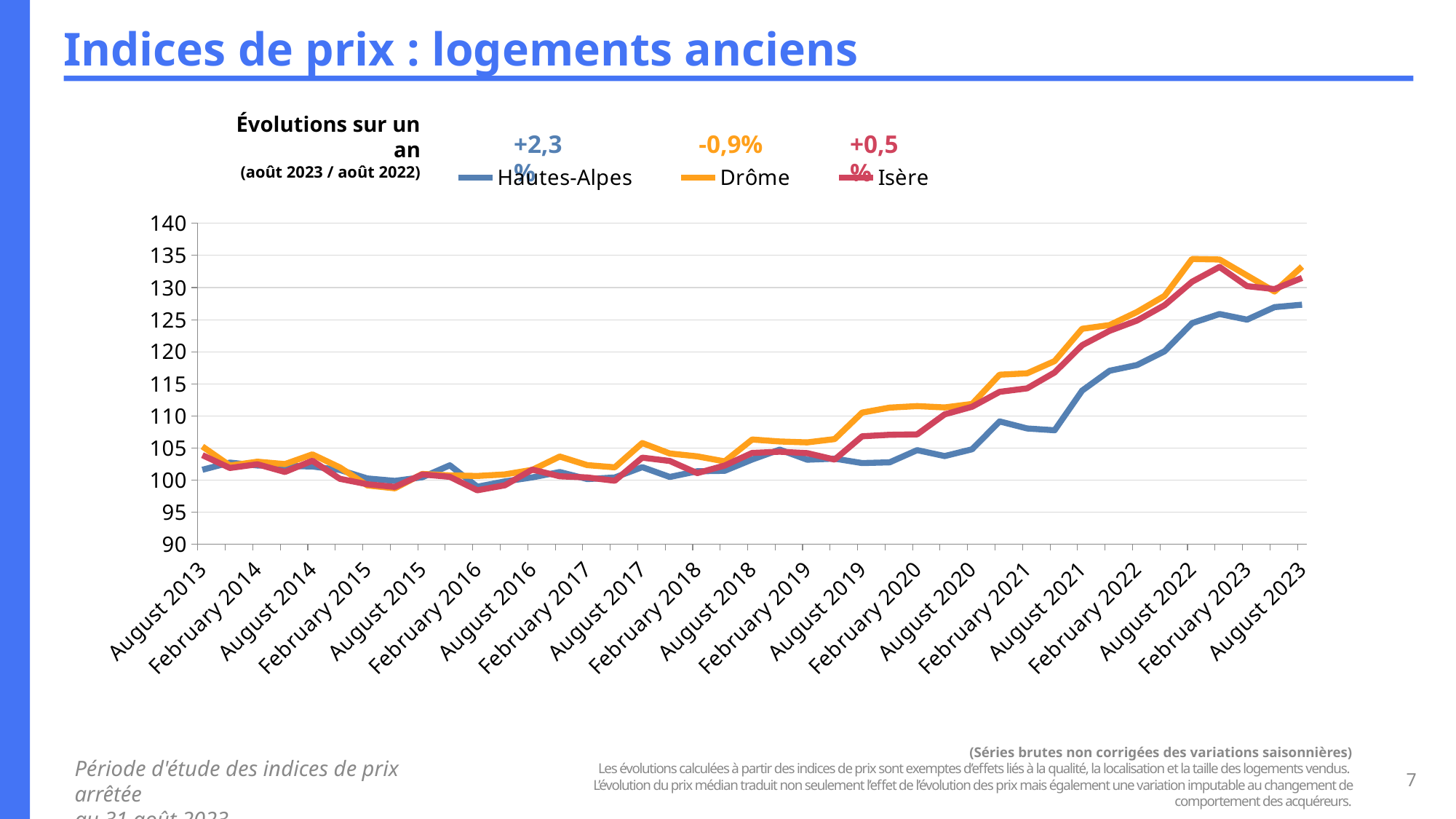
Overall, do the index values rise or fall from August 2013 to August 2023? rise How many date labels are shown along the x axis of the chart? 21 What kind of chart is shown on the slide? line chart What one-year evolution (août 2023 / août 2022) is shown for Drôme? -0,9% At August 2021, which series is higher, Drôme or Hautes-Alpes? Drôme Which series has the highest value at August 2022? Drôme How many series does the chart legend list? 3 What is the title of the slide containing the chart? Indices de prix : logements anciens Which series has the lowest value at August 2023? Hautes-Alpes Is the value for Hautes-Alpes at August 2023 greater or less than 125? greater Is the value for Drôme at August 2022 greater or less than 130? greater